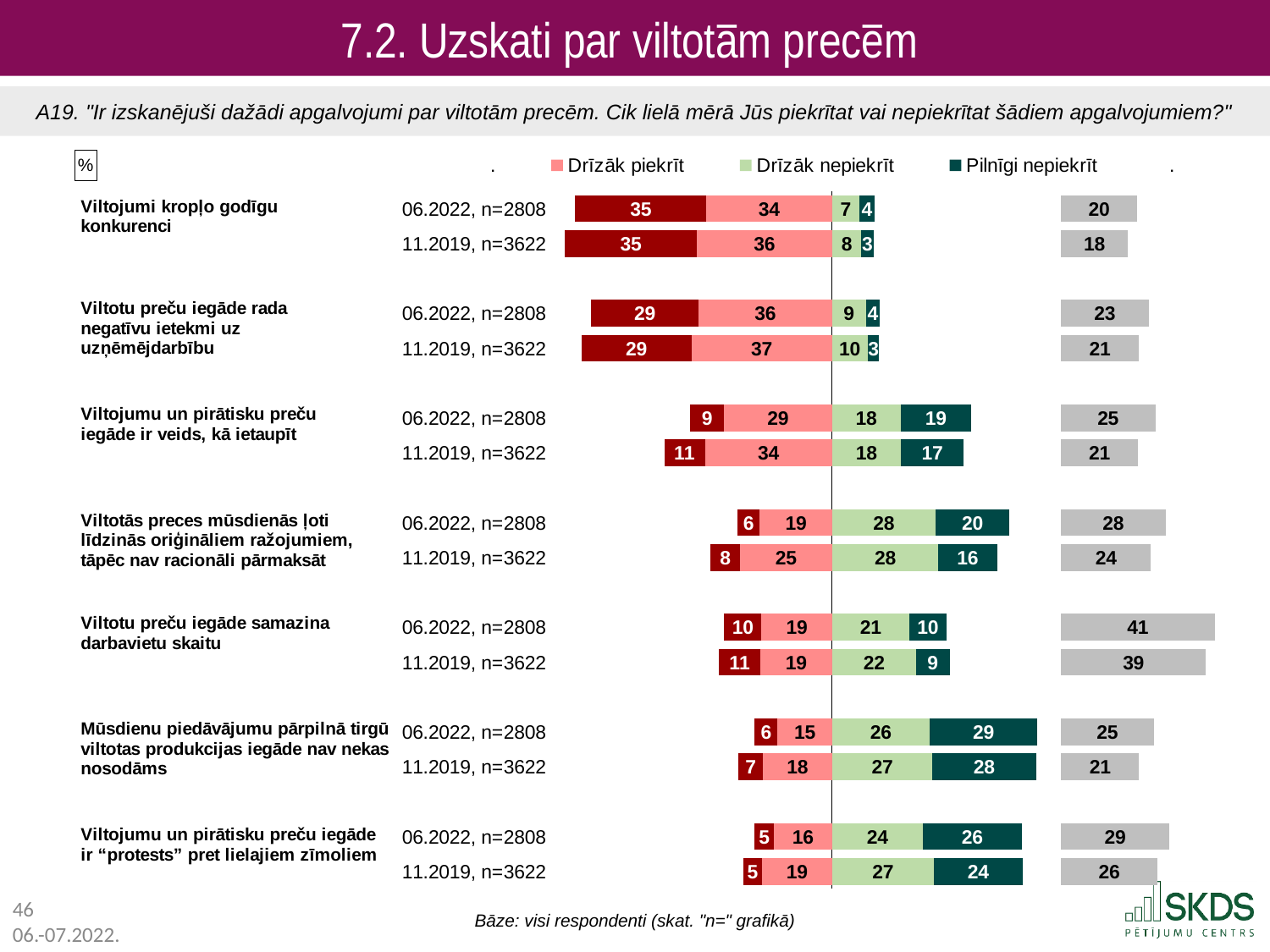
For the statement "Viltojumi kropļo godīgu konkurenci" in 06.2022, what is the value for "Drīzāk piekrīt"? 34 For the statement "Viltotās preces mūsdienās ļoti līdzinās oriģināliem ražojumiem, tāpēc nav racionāli pārmaksāt", did the "Drīzāk piekrīt" value rise or fall from 11.2019 to 06.2022? Fall For the statement "Viltotās preces mūsdienās ļoti līdzinās oriģināliem ražojumiem, tāpēc nav racionāli pārmaksāt" in 06.2022, what is the difference between "Drīzāk nepiekrīt" and "Drīzāk piekrīt"? 9 Which statement has the lowest "Drīzāk piekrīt" value in 06.2022? Mūsdienu piedāvājumu pārpilnā tirgū viltotas produkcijas iegāde nav nekas nosodāms For the statement "Mūsdienu piedāvājumu pārpilnā tirgū viltotas produkcijas iegāde nav nekas nosodāms" in 06.2022, what is the value for "Pilnīgi nepiekrīt"? 29 For the statement "Viltotu preču iegāde samazina darbavietu skaitu" in 11.2019, what is the value for "Drīzāk nepiekrīt"? 22 For the statement "Viltojumi kropļo godīgu konkurenci" in 06.2022, what is the total of the four coloured stacked segments (35, 34, 7, 4)? 80 For the statement "Viltojumu un pirātisku preču iegāde ir veids, kā ietaupīt", is the "Pilnīgi nepiekrīt" value larger in 06.2022 or in 11.2019? 06.2022 Which statement has the highest "Pilnīgi nepiekrīt" value in 06.2022? Mūsdienu piedāvājumu pārpilnā tirgū viltotas produkcijas iegāde nav nekas nosodāms How many statements are shown in the chart? 7 Which legend entry is shown in dark green? Pilnīgi nepiekrīt What kind of chart is shown on the slide? Stacked bar chart